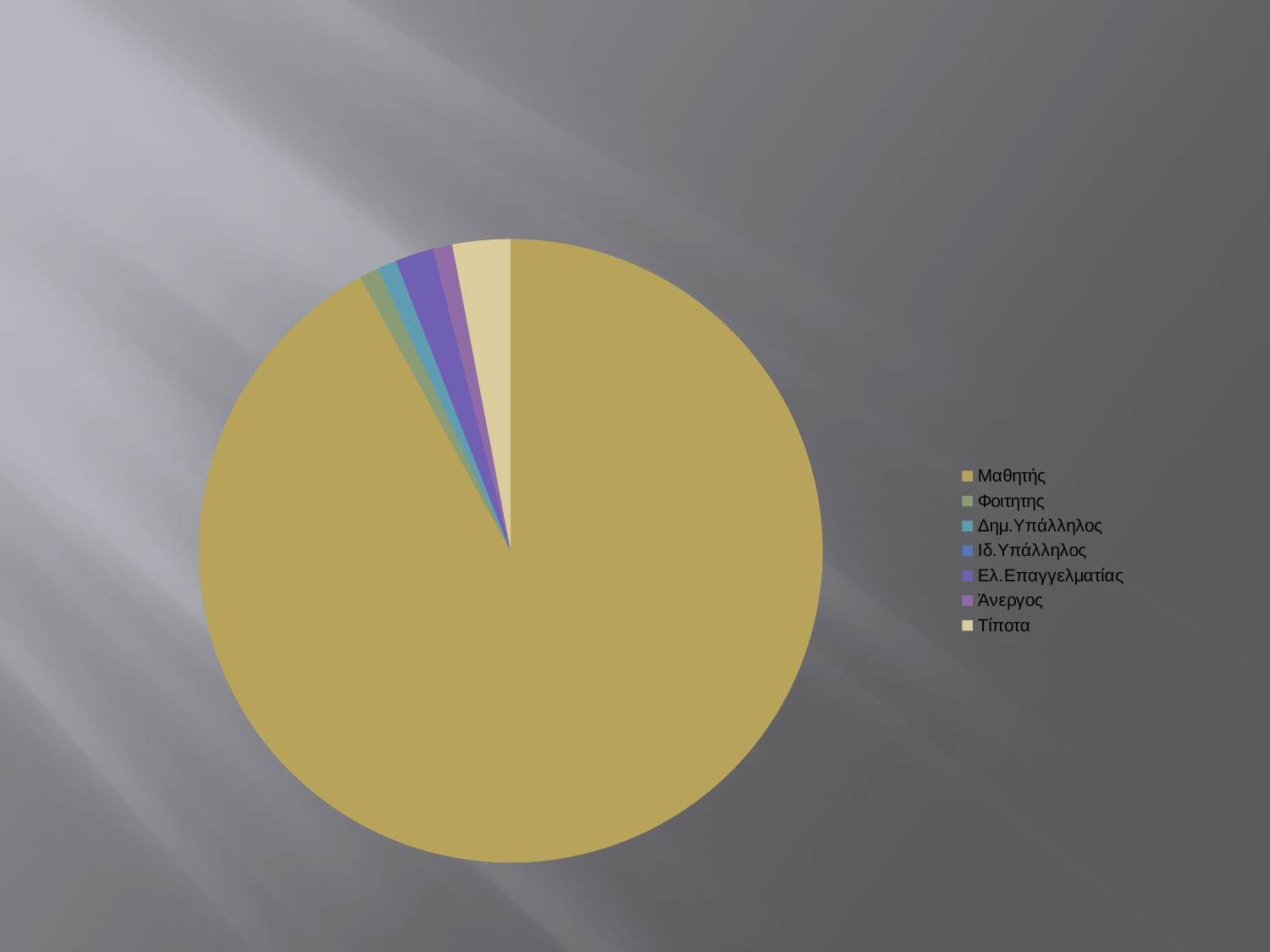
Which slice is larger, Μαθητής or Τίποτα? Μαθητής Which category has the largest slice of the pie chart? Μαθητής Which slice is larger, Τίποτα or Άνεργος? Τίποτα Which slice is larger, Ελ.Επαγγελματίας or Μαθητής? Μαθητής Which category is listed last in the legend? Τίποτα What kind of chart is shown on the slide? pie chart How many categories does the legend of the pie chart list? 7 Which category is listed first in the legend? Μαθητής